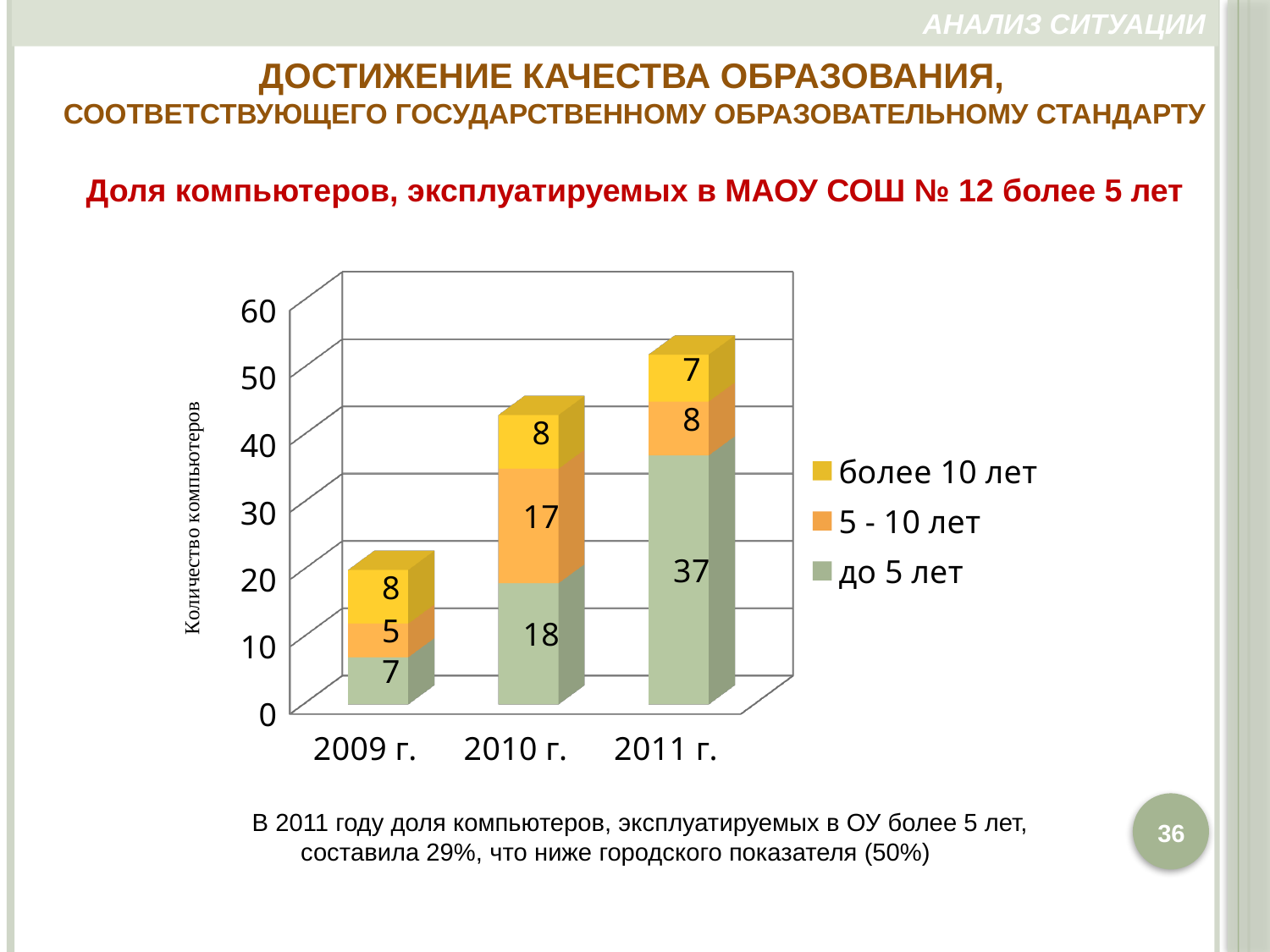
What is the total of the stacked bar for 2011 г.? 52 What is the value for "5 - 10 лет" in 2010 г.? 17 What is the difference between the "до 5 лет" values for 2011 г. and 2010 г.? 19 Which is larger: "5 - 10 лет" in 2010 г. or "5 - 10 лет" in 2011 г.? 2010 г. How many series does the legend list? 3 What kind of chart is shown on the slide? Stacked bar chart What is the total of the stacked bar for 2010 г.? 43 Which year has the highest value for "до 5 лет"? 2011 г. Which year has the lowest value for "5 - 10 лет"? 2009 г. What is the value for "более 10 лет" in 2009 г.? 8 What is the value for "до 5 лет" in 2011 г.? 37 How many years are shown on the x axis? 3